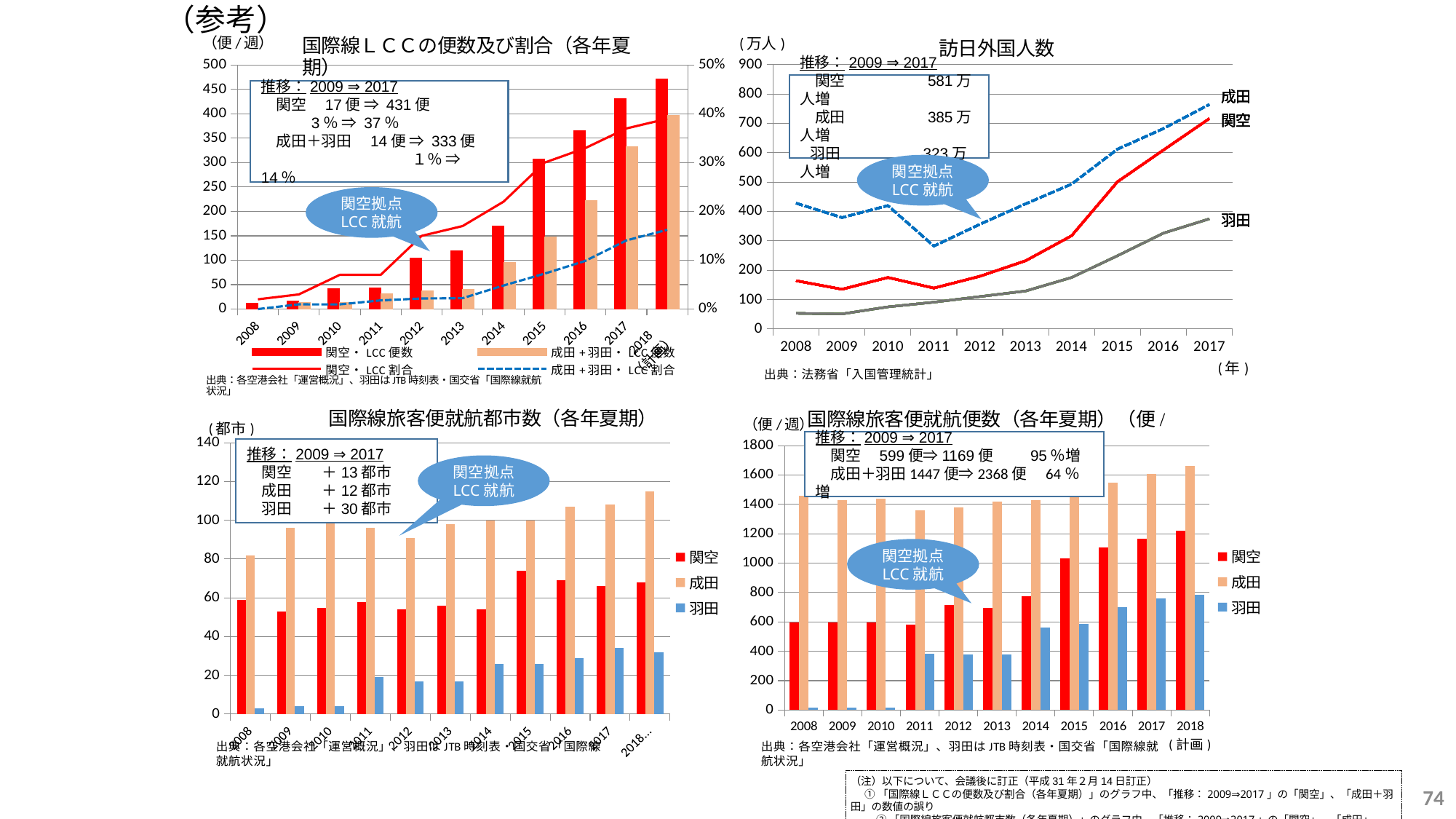
In the 訪日外国人数 chart, is the value for 羽田 in 2008 greater or less than 100? less In the 訪日外国人数 chart, is the value for 関空 in 2017 greater or less than 600? greater In the 訪日外国人数 chart, which airport has the lowest value in 2017? 羽田 In the 国際線旅客便就航便数（各年夏期） chart at the bottom right, which airport has the lowest value in 2008? 羽田 What kind of chart is the 国際線旅客便就航都市数（各年夏期） chart at the bottom left? bar chart In the 国際線ＬＣＣの便数及び割合（各年夏期） chart at the top left, how many series does the legend list? 4 In the 国際線旅客便就航都市数（各年夏期） chart, how many years are shown on the x axis? 11 In the 国際線旅客便就航便数（各年夏期） chart at the bottom right, is the value for 成田 in 2018 greater or less than 1600? greater In the 訪日外国人数 chart, which airport has the highest value in 2017? 成田 What kind of chart is the 訪日外国人数 chart at the top right? line chart In the 訪日外国人数 chart, how many airports (series) are plotted? 3